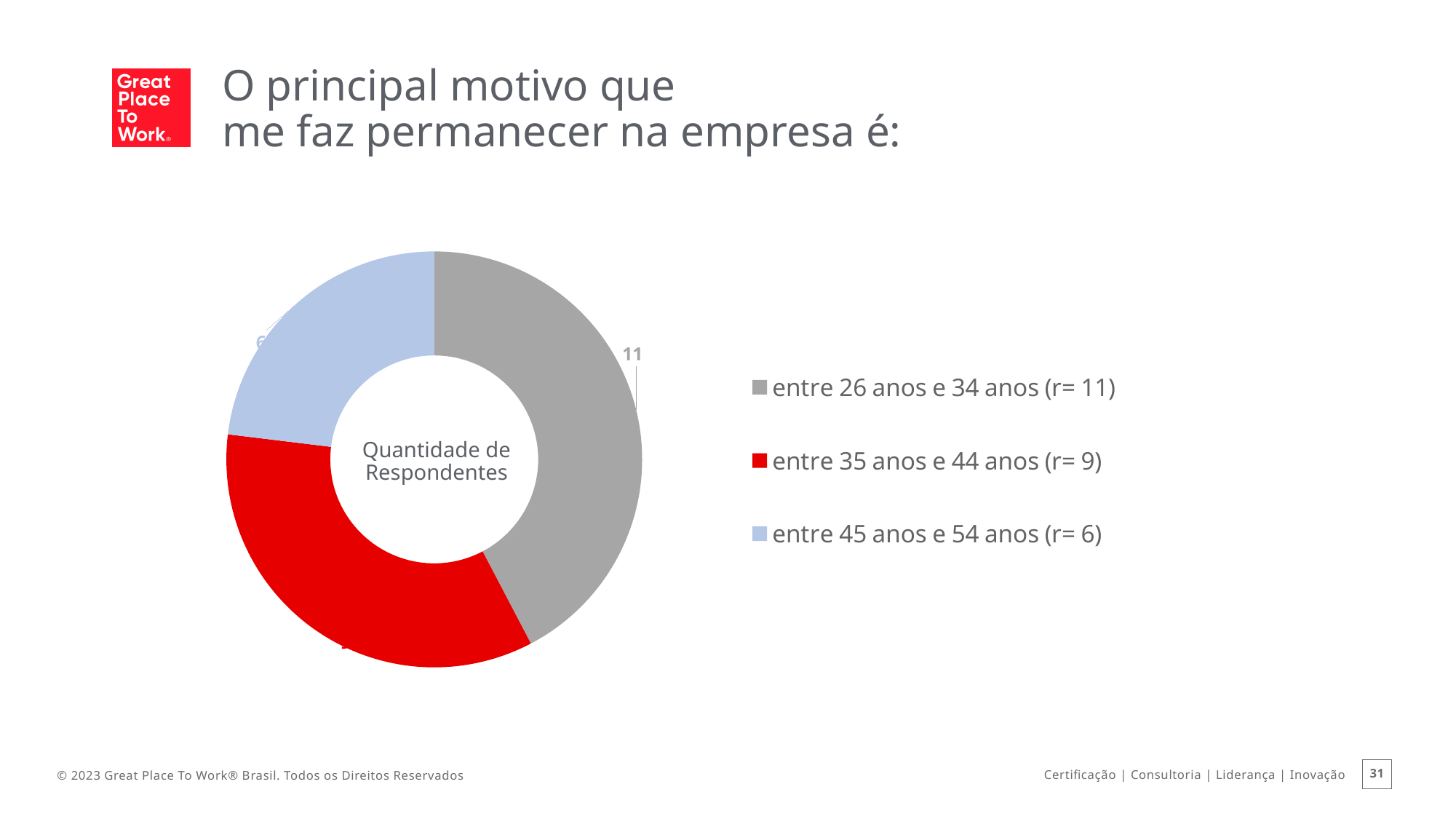
How many categories does the donut chart show? 3 What is the difference in respondents between 'entre 26 anos e 34 anos' and 'entre 45 anos e 54 anos'? 5 What kind of chart is shown on the slide? Donut (pie) chart What is the number of respondents for 'entre 45 anos e 54 anos'? 6 Which colour represents 'entre 35 anos e 44 anos' in the chart? Red Which age group has the largest number of respondents? entre 26 anos e 34 anos Which has more respondents: 'entre 35 anos e 44 anos' or 'entre 45 anos e 54 anos'? entre 35 anos e 44 anos What is the number of respondents for 'entre 26 anos e 34 anos'? 11 What is the number of respondents for 'entre 35 anos e 44 anos'? 9 What text is shown in the centre of the donut chart? Quantidade de Respondentes What is the total number of respondents across all three age groups? 26 Which age group has the smallest number of respondents? entre 45 anos e 54 anos